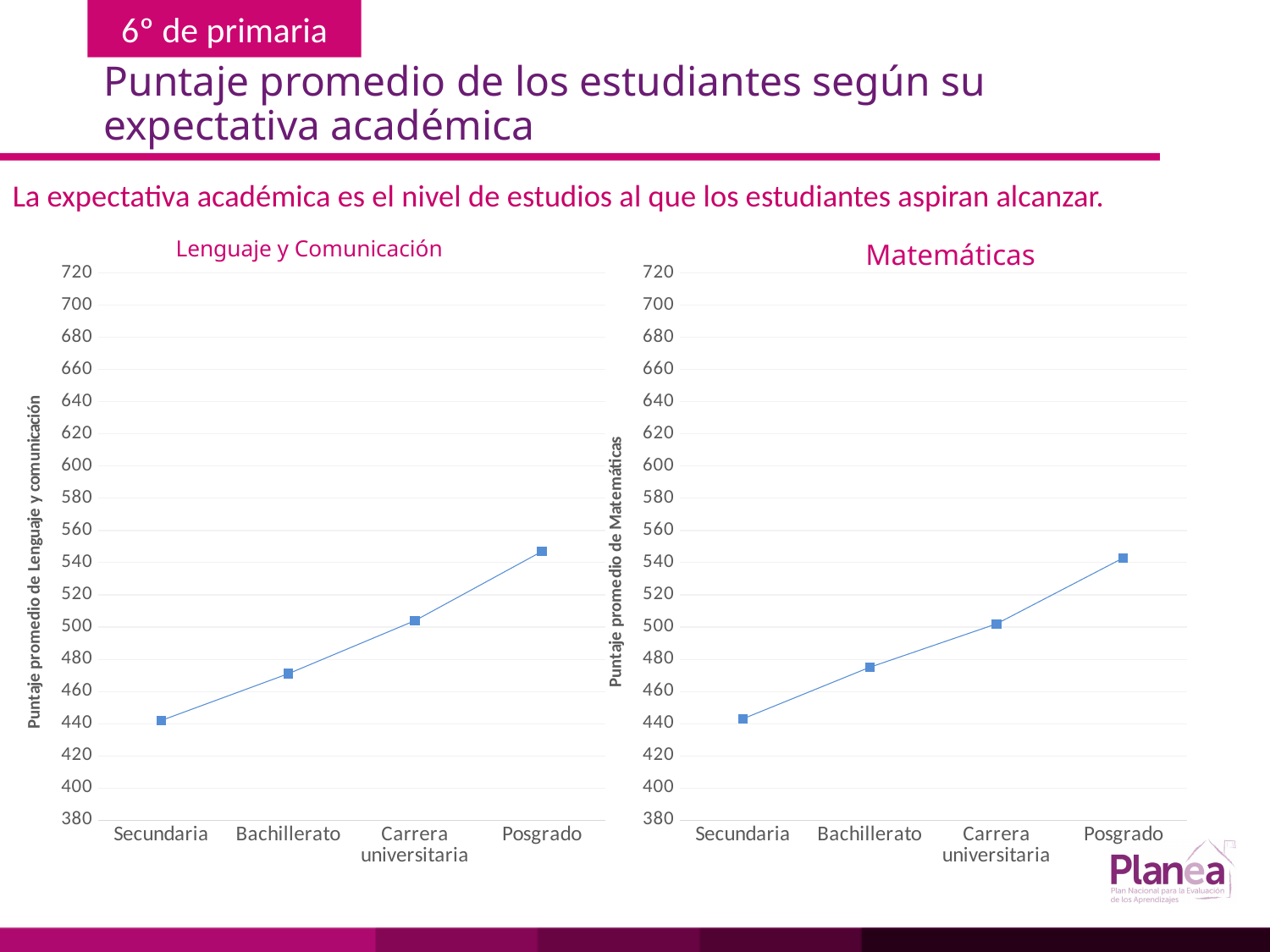
In the Matemáticas chart, how many categories are plotted on the x axis? 4 In the Lenguaje y Comunicación chart, which is larger, the value for Carrera universitaria or the value for Bachillerato? Carrera universitaria In the Lenguaje y Comunicación chart, which category has the highest average score? Posgrado In the Lenguaje y Comunicación chart, what kind of chart is shown? line chart In the Lenguaje y Comunicación chart, what is the label of the vertical axis? Puntaje promedio de Lenguaje y comunicación In the Matemáticas chart, which category has the lowest average score? Secundaria In the Matemáticas chart, is the value for Bachillerato greater or less than 460? greater In the Lenguaje y Comunicación chart, is the value for Secundaria greater or less than 460? less In the Matemáticas chart, is the value for Posgrado greater or less than 520? greater In the Lenguaje y Comunicación chart, do the values rise or fall from Secundaria to Posgrado? rise What is the title of the chart on the right side of the slide? Matemáticas